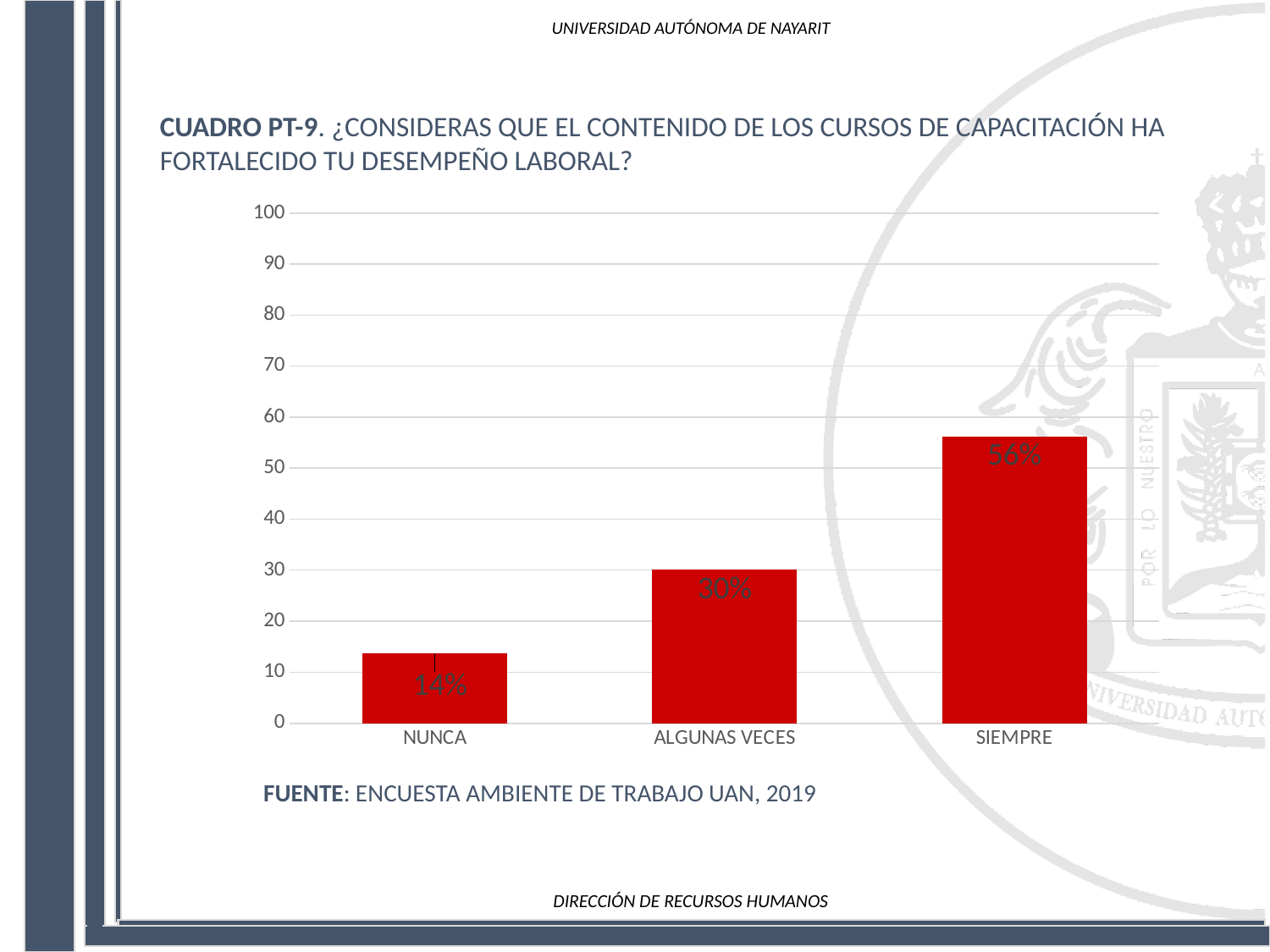
What is the value for ALGUNAS VECES? 30% What is the value for SIEMPRE? 56% What is the difference between the values for SIEMPRE and ALGUNAS VECES? 26% What kind of chart is shown on the slide? bar chart What is the difference between the values for ALGUNAS VECES and NUNCA? 16% Which category has the highest value? SIEMPRE Do the values rise or fall from NUNCA to SIEMPRE along the x axis? rise Which category has the lowest value? NUNCA Is the value for SIEMPRE greater or less than 50? greater Which is larger, the value for NUNCA or the value for ALGUNAS VECES? ALGUNAS VECES What is the value for NUNCA? 14% How many categories are shown on the x axis? 3